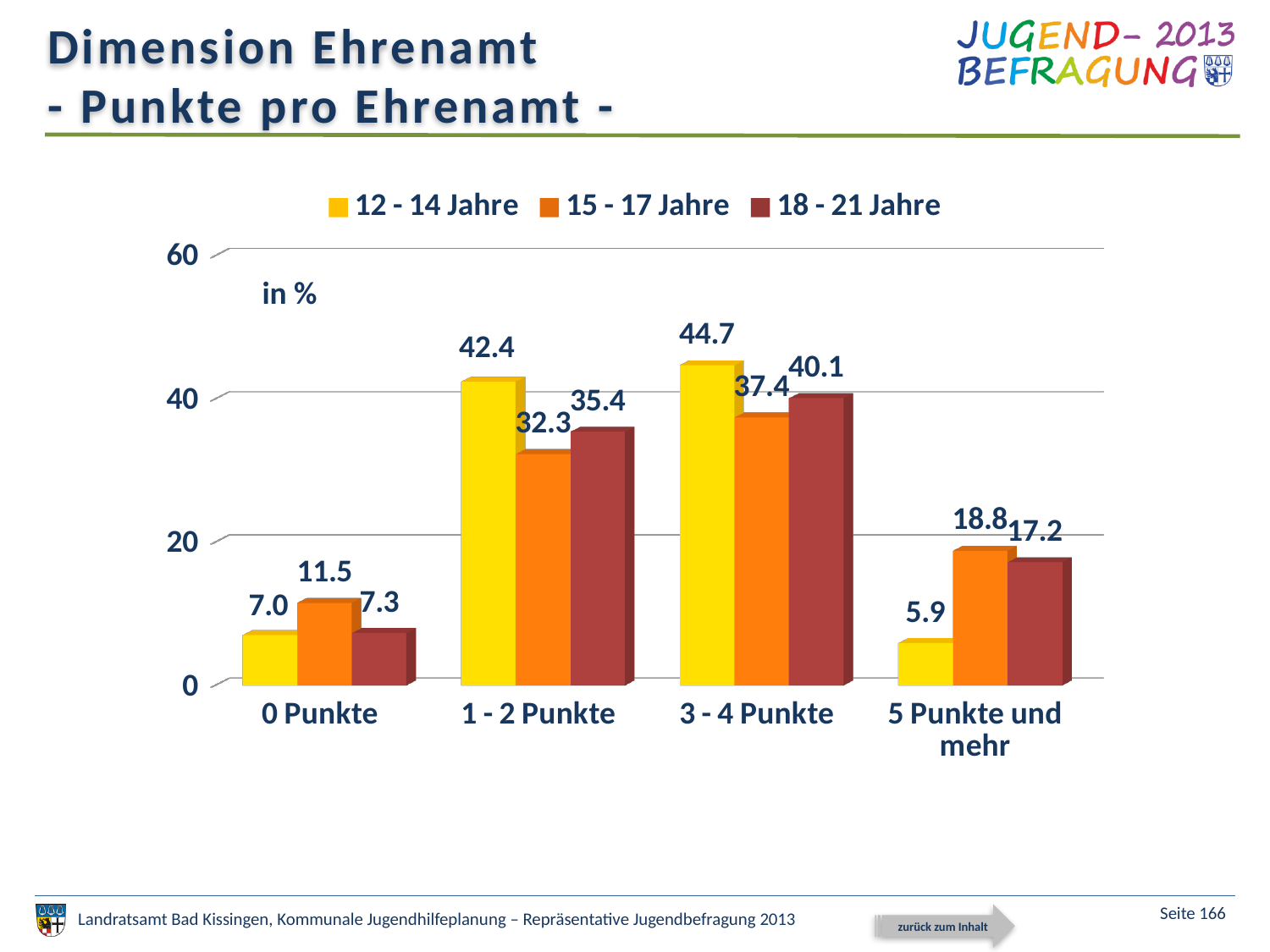
How many categories are shown on the x axis? 4 Is the value for 18 - 21 Jahre in the 1 - 2 Punkte category greater or less than 40? less What kind of chart is shown on the slide? bar chart How many series does the legend list? 3 What is the value for 15 - 17 Jahre in the 0 Punkte category? 11.5 What is the value for 12 - 14 Jahre in the 1 - 2 Punkte category? 42.4 Which category has the highest value for 12 - 14 Jahre? 3 - 4 Punkte Which series is shown in yellow in the legend? 12 - 14 Jahre What is the difference between the 12 - 14 Jahre and 15 - 17 Jahre values in the 1 - 2 Punkte category? 10.1 Which category has the lowest value for 15 - 17 Jahre? 0 Punkte What is the value for 18 - 21 Jahre in the 5 Punkte und mehr category? 17.2 In the 3 - 4 Punkte category, which is larger: the value for 15 - 17 Jahre or for 18 - 21 Jahre? 18 - 21 Jahre